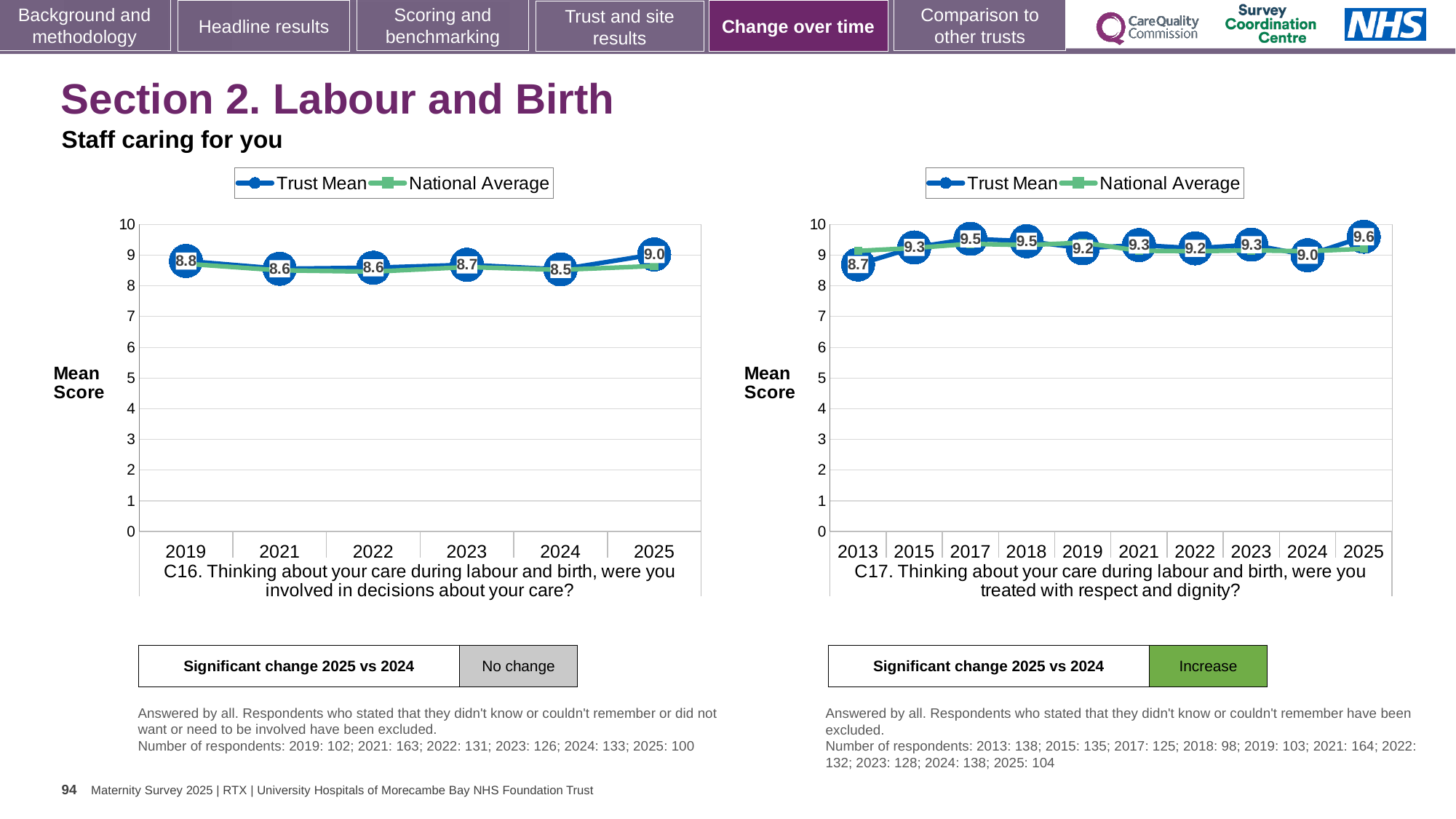
In the C17 chart (right), what is the Trust Mean score for 2013? 8.7 In the C17 chart (right), how many years are shown on the x axis? 10 In the C17 chart (right), which is larger, the Trust Mean score for 2024 or for 2025? 2025 In the C16 chart (left), how many years are shown on the x axis? 6 In the C16 chart (left), what is the difference between the Trust Mean scores for 2025 and 2024? 0.5 In the C16 chart (left), what is the Trust Mean score for 2025? 9.0 In the C16 chart (left), which year has the lowest Trust Mean score? 2024 In the C17 chart (right), which year has the highest Trust Mean score? 2025 In the C16 chart (left), what is the Trust Mean score for 2024? 8.5 How many series does the legend of the C16 chart (left) list? 2 In the C17 chart (right), what is the difference between the Trust Mean scores for 2025 and 2013? 0.9 What kind of chart is the C17 chart (right)? Line chart